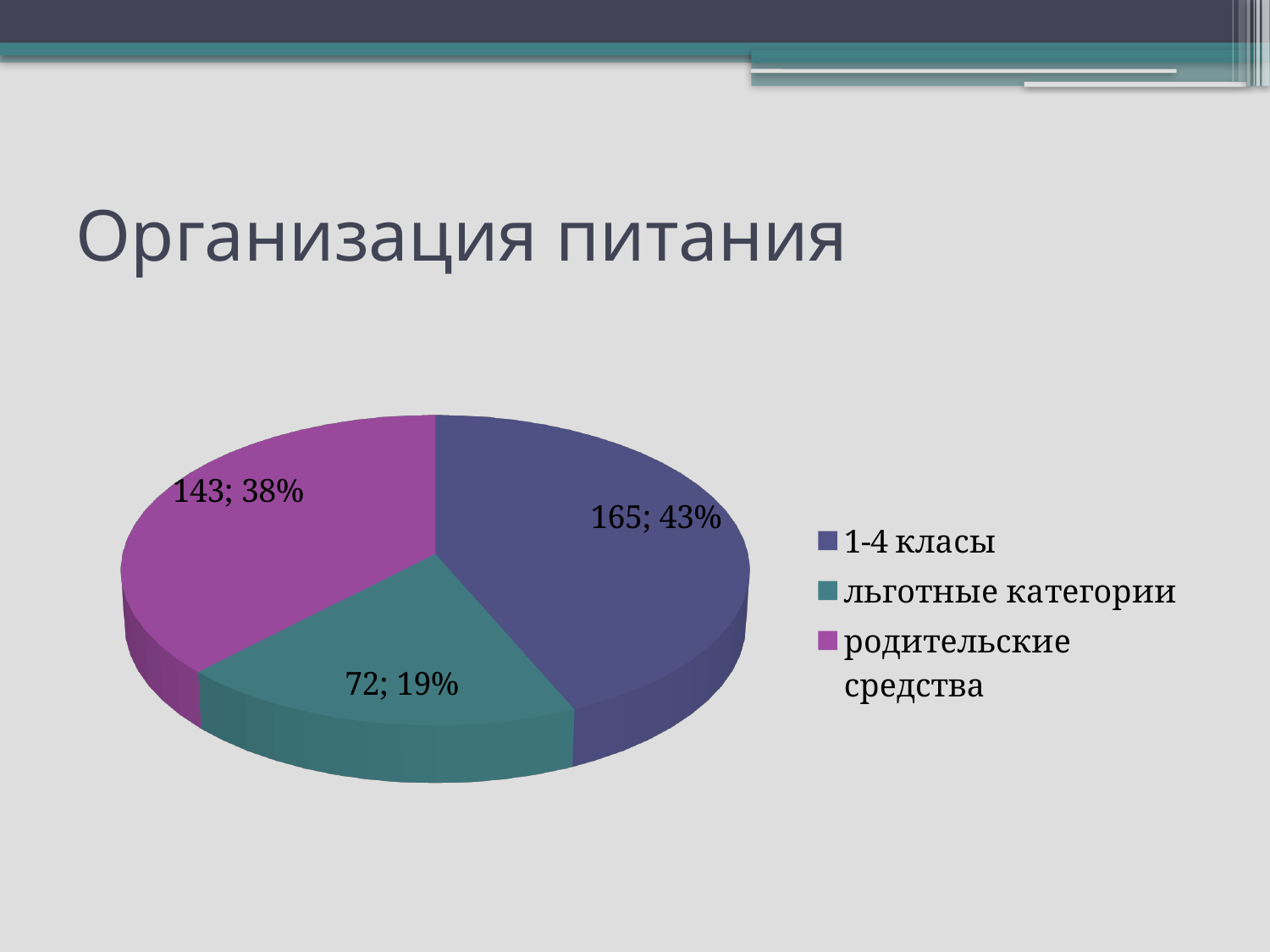
What is the value for "льготные категории"? 72 What share of the pie does "льготные категории" take? 19% Which is larger, the value for "родительские средства" or the value for "льготные категории"? родительские средства What is the difference between the values for "1-4 класы" and "родительские средства"? 22 What share of the pie does "родительские средства" take? 38% What is the value for "родительские средства"? 143 What kind of chart is shown on the slide? pie chart How many categories does the legend list? 3 Which category has the smallest slice? льготные категории What share of the pie does "1-4 класы" take? 43% What is the value for "1-4 класы"? 165 Which category has the largest slice? 1-4 класы